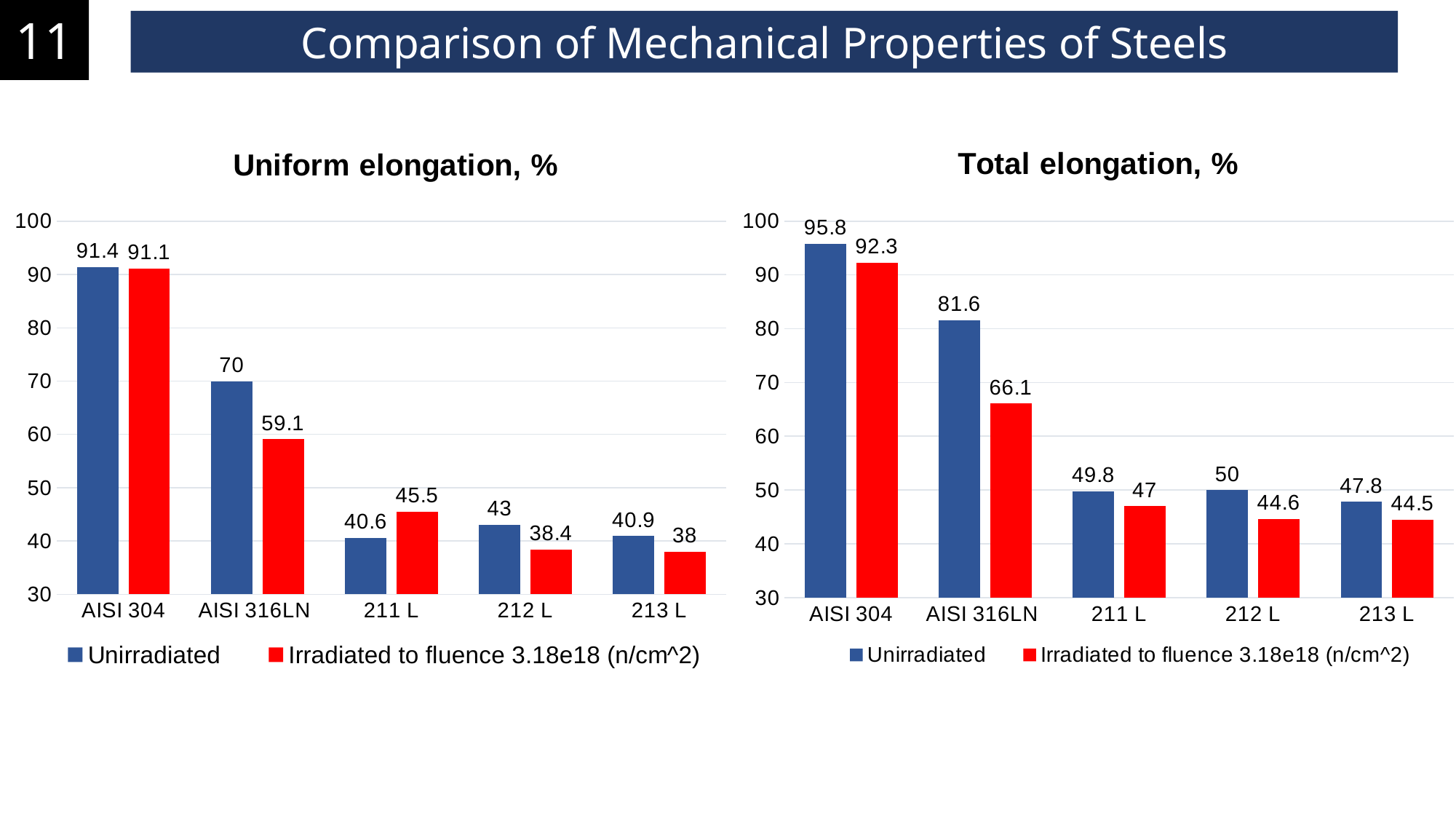
How many series does the legend of the 'Uniform elongation, %' chart list? 2 How many categories are shown on the x axis of the 'Total elongation, %' chart? 5 In the 'Uniform elongation, %' chart, what is the value for 211 L irradiated to fluence 3.18e18 (n/cm^2)? 45.5 What type of chart is the 'Total elongation, %' chart? Bar chart In the 'Uniform elongation, %' chart, what is the Unirradiated value for AISI 316LN? 70 In the 'Uniform elongation, %' chart, which is larger for 211 L: the Unirradiated value or the irradiated value? Irradiated to fluence 3.18e18 (n/cm^2) In the 'Total elongation, %' chart, which category has the highest Unirradiated value? AISI 304 In the 'Total elongation, %' chart, what is the Unirradiated value for AISI 304? 95.8 In the 'Total elongation, %' chart, what is the irradiated value for 213 L? 44.5 In the 'Total elongation, %' chart, what is the difference between the Unirradiated and irradiated values for AISI 316LN? 15.5 In the 'Uniform elongation, %' chart, which category has the lowest irradiated value? 213 L In the 'Uniform elongation, %' chart, what is the difference between the Unirradiated and irradiated values for AISI 316LN? 10.9